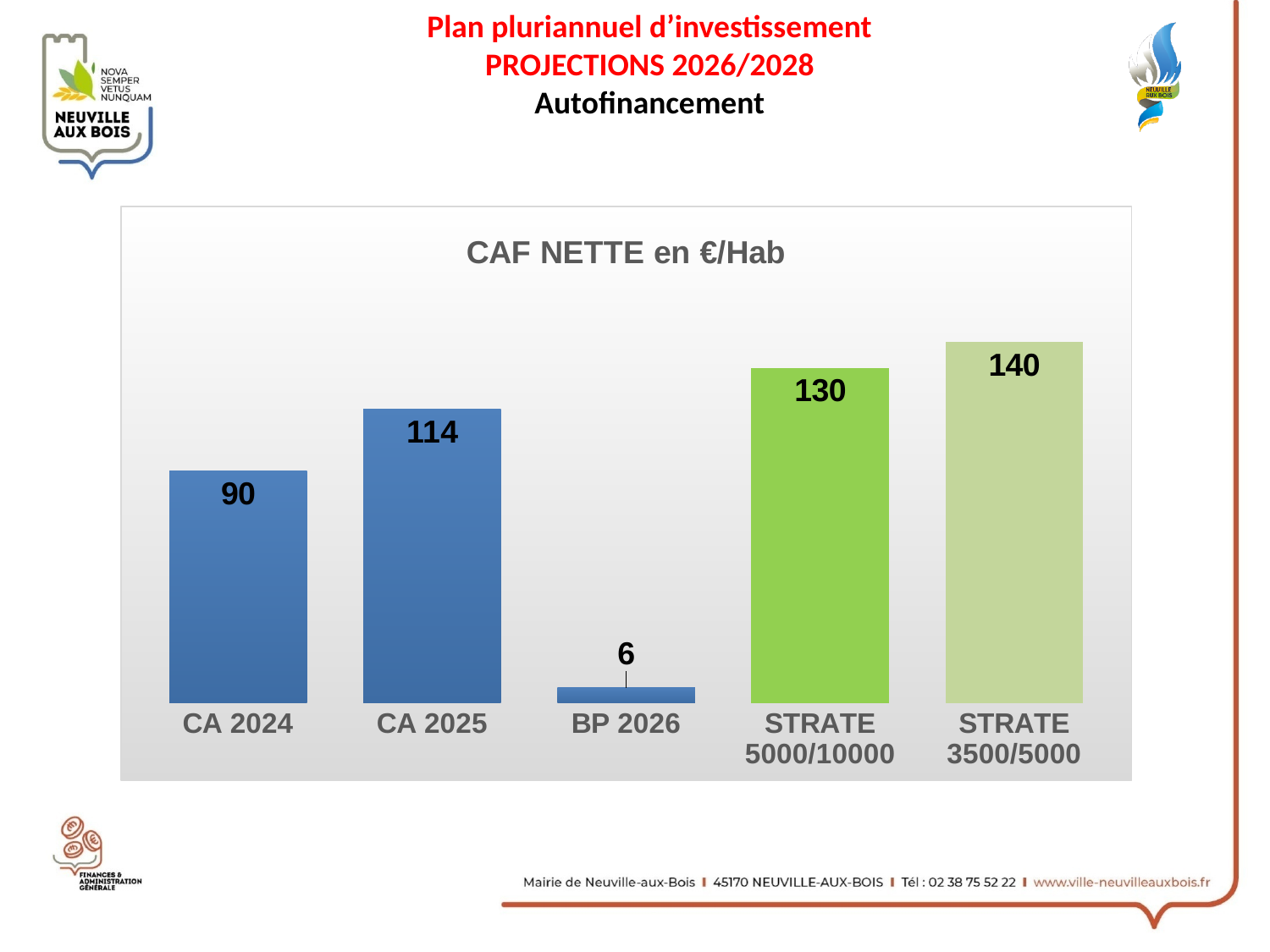
What is the value for BP 2026? 6 How many categories are shown on the chart? 5 What is the title of the chart? CAF NETTE en €/Hab What is the value for STRATE 3500/5000? 140 Which category has the highest value? STRATE 3500/5000 What is the difference between the values for CA 2025 and CA 2024? 24 What is the value for CA 2025? 114 What is the value for CA 2024? 90 Which category has the lowest value? BP 2026 Which is larger, the value for CA 2025 or the value for STRATE 5000/10000? STRATE 5000/10000 What kind of chart is shown on the slide? Bar chart What is the value for STRATE 5000/10000? 130